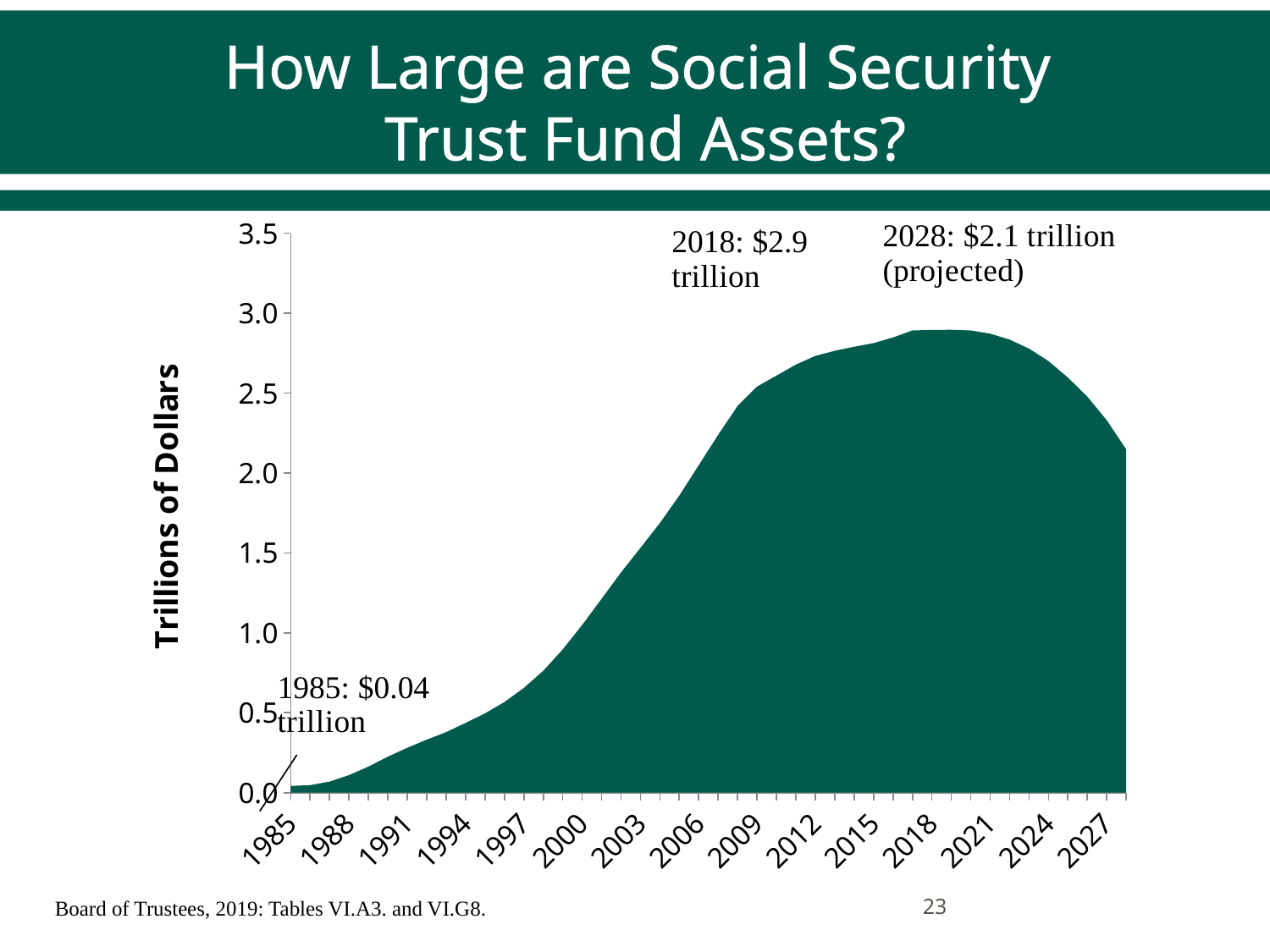
Is the value for 2012 greater or less than 2.5? greater What is the label on the vertical axis? Trillions of Dollars Which is larger, the 2018 value or the projected 2028 value? 2018 What kind of chart is shown on the slide? area chart Do trust fund assets rise or fall between 1985 and 2018? rise What is the value of Social Security trust fund assets in 2018? $2.9 trillion What is the value of trust fund assets in 1985? $0.04 trillion Of the three annotated years (1985, 2018, 2028), which has the highest value? 2018 Is the value for 1991 greater or less than 0.5? less What is the projected value of trust fund assets in 2028? $2.1 trillion (projected) How much larger are trust fund assets in 2018 than the projected value for 2028? $0.8 trillion By how much did trust fund assets grow from 1985 to 2018? $2.86 trillion